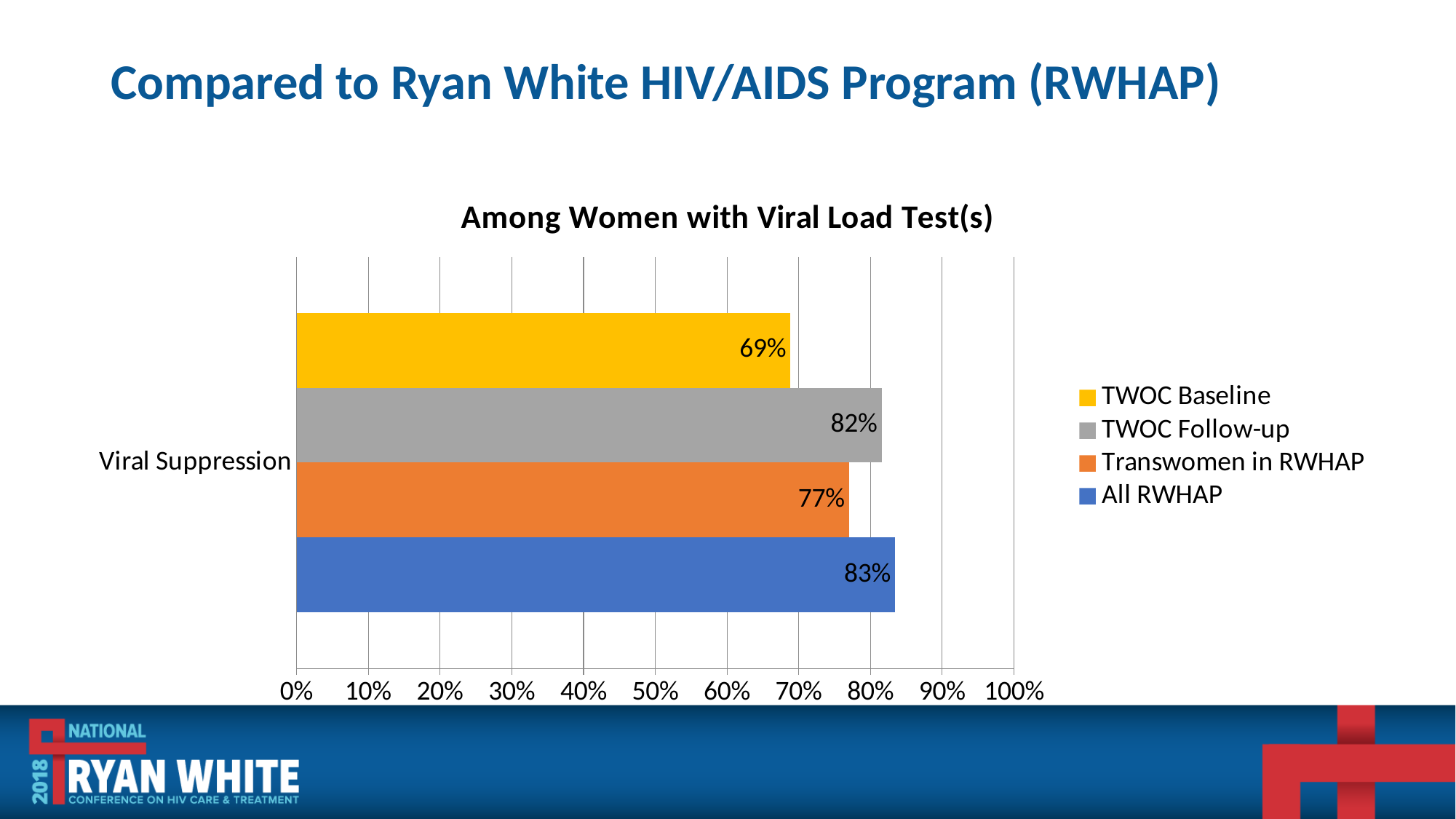
What is the difference between the All RWHAP and Transwomen in RWHAP viral suppression values? 6% What is the title of the chart? Among Women with Viral Load Test(s) What is the viral suppression value for TWOC Follow-up? 82% What kind of chart is shown on the slide? Bar chart What is the difference between the TWOC Follow-up and TWOC Baseline viral suppression values? 13% What is the viral suppression value for TWOC Baseline? 69% What is the viral suppression value for All RWHAP? 83% What is the viral suppression value for Transwomen in RWHAP? 77% Which series has the lowest viral suppression value? TWOC Baseline How many series does the legend list? 4 Which is larger, the viral suppression value for TWOC Follow-up or for Transwomen in RWHAP? TWOC Follow-up Is the viral suppression value for TWOC Baseline greater or less than 70%? less